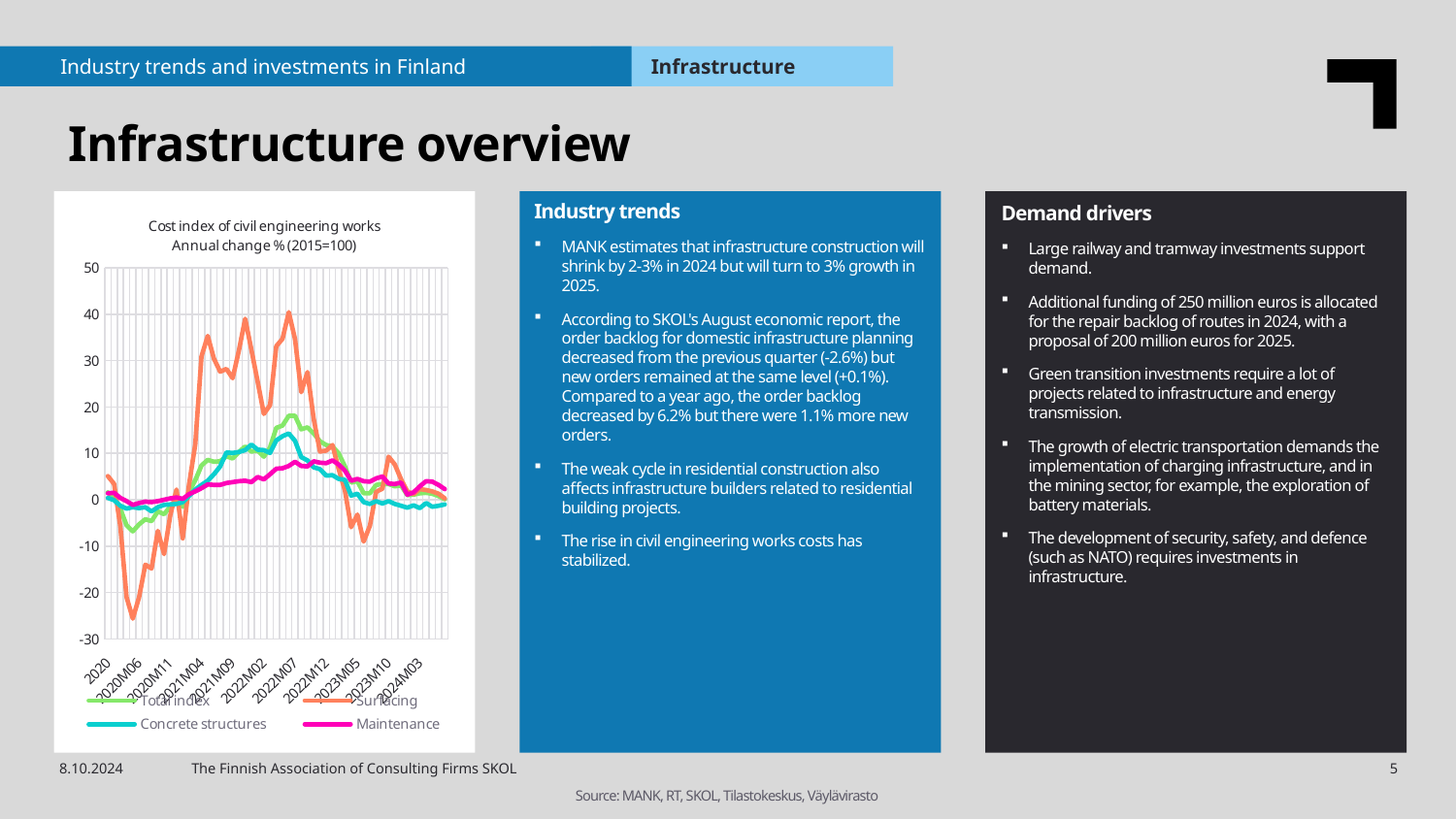
What kind of chart is shown on the slide? line chart Is the peak value of the Surfacing series greater or less than 30? greater Is the peak value of the Total index series greater or less than 10? greater Is the peak value of the Maintenance series greater or less than 20? less How many date labels are shown on the x axis of the chart? 11 Which series is drawn in orange in the chart? Surfacing Which series drops to the lowest value in the chart? Surfacing What is the title of the chart? Cost index of civil engineering works Annual change % (2015=100) How many series does the chart's legend list? 4 Does the Surfacing series rise or fall between 2022M07 and 2023M05? fall Which series reaches the highest peak in the chart? Surfacing